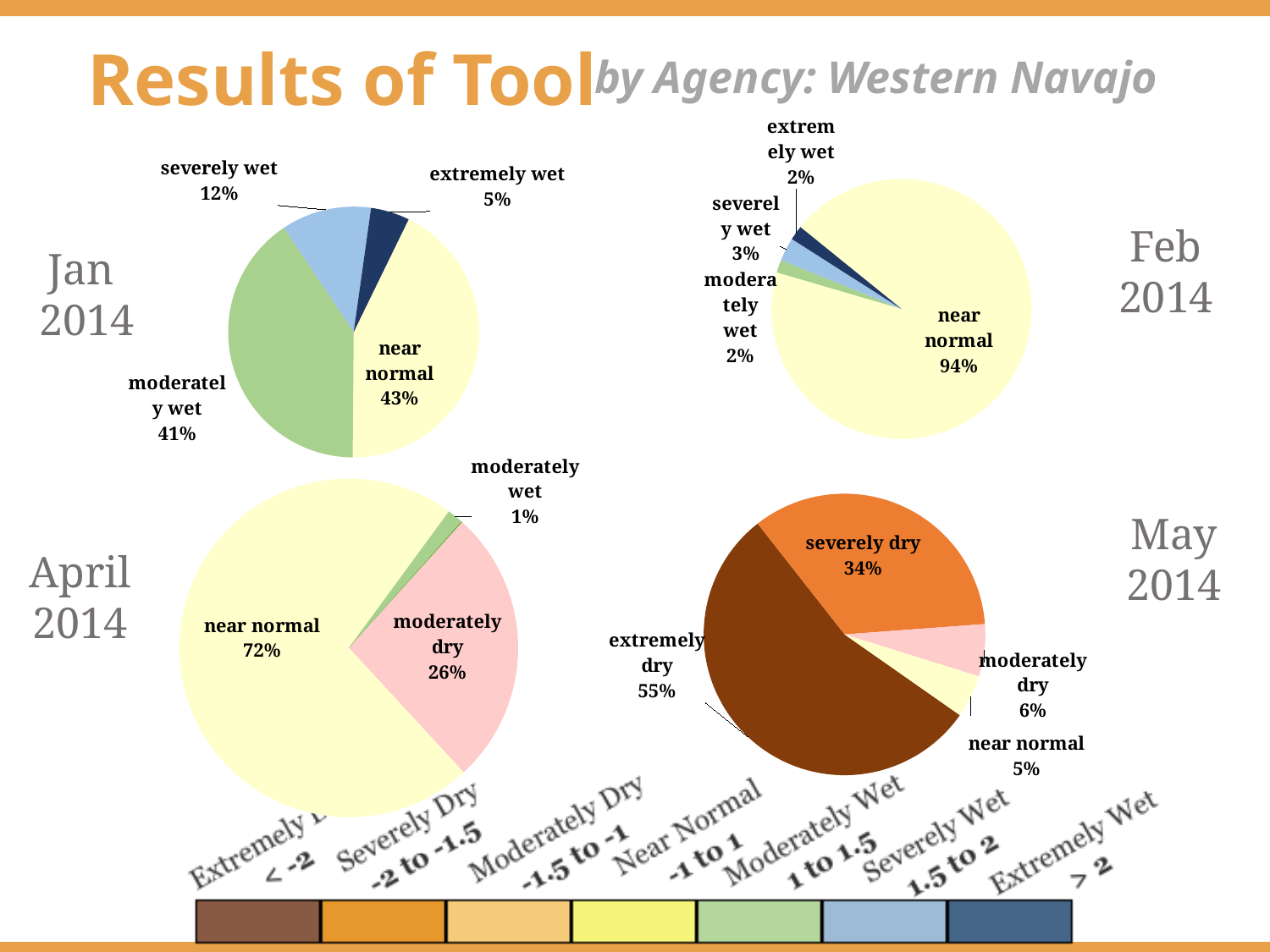
In the Jan 2014 pie chart, what share is labelled severely wet? 12% In the Jan 2014 pie chart, what share is labelled near normal? 43% In the Feb 2014 pie chart, what share is labelled near normal? 94% In the April 2014 pie chart, what is the difference between the near normal share and the moderately dry share? 46% In the May 2014 pie chart, which is larger, moderately dry or near normal? moderately dry In the April 2014 pie chart, what share is labelled moderately dry? 26% In the Feb 2014 pie chart, what share is labelled severely wet? 3% In the Jan 2014 pie chart, which category has the smallest share? extremely wet In the May 2014 pie chart, what share is labelled severely dry? 34% What kind of chart is used for each month on this slide? pie chart In the May 2014 pie chart, which category has the largest share? extremely dry How many slices does the Feb 2014 pie chart have? 4